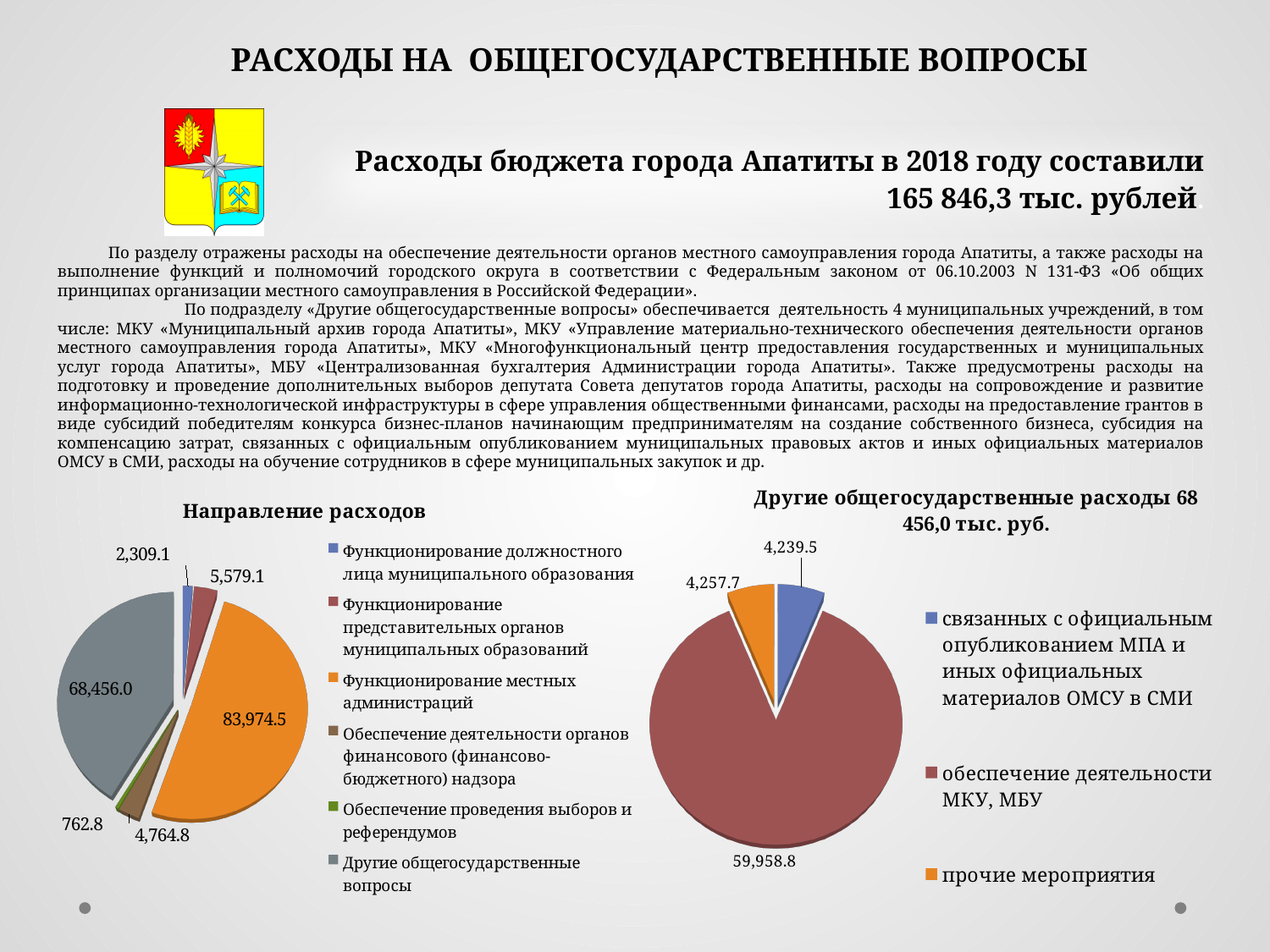
In the "Направление расходов" chart, which category has the smallest value? Обеспечение проведения выборов и референдумов In the "Направление расходов" chart, which category has the largest value? Функционирование местных администраций In the "Направление расходов" chart, which is larger: "Функционирование представительных органов муниципальных образований" or "Функционирование должностного лица муниципального образования"? Функционирование представительных органов муниципальных образований In the "Направление расходов" chart, what is the value for "Обеспечение проведения выборов и референдумов"? 762.8 How many categories does the "Направление расходов" chart show? 6 In the "Другие общегосударственные расходы" chart, what is the value for "прочие мероприятия"? 4,257.7 In the "Другие общегосударственные расходы" chart, which category has the largest value? обеспечение деятельности МКУ, МБУ In the "Направление расходов" chart, what is the difference between the values for "Функционирование местных администраций" and "Другие общегосударственные вопросы"? 15,518.5 In the "Другие общегосударственные расходы" chart, what is the value for "обеспечение деятельности МКУ, МБУ"? 59,958.8 In the "Направление расходов" chart, what is the value for "Функционирование местных администраций"? 83,974.5 How many entries does the legend of the "Другие общегосударственные расходы" chart list? 3 What type of chart is the "Направление расходов" chart? pie chart